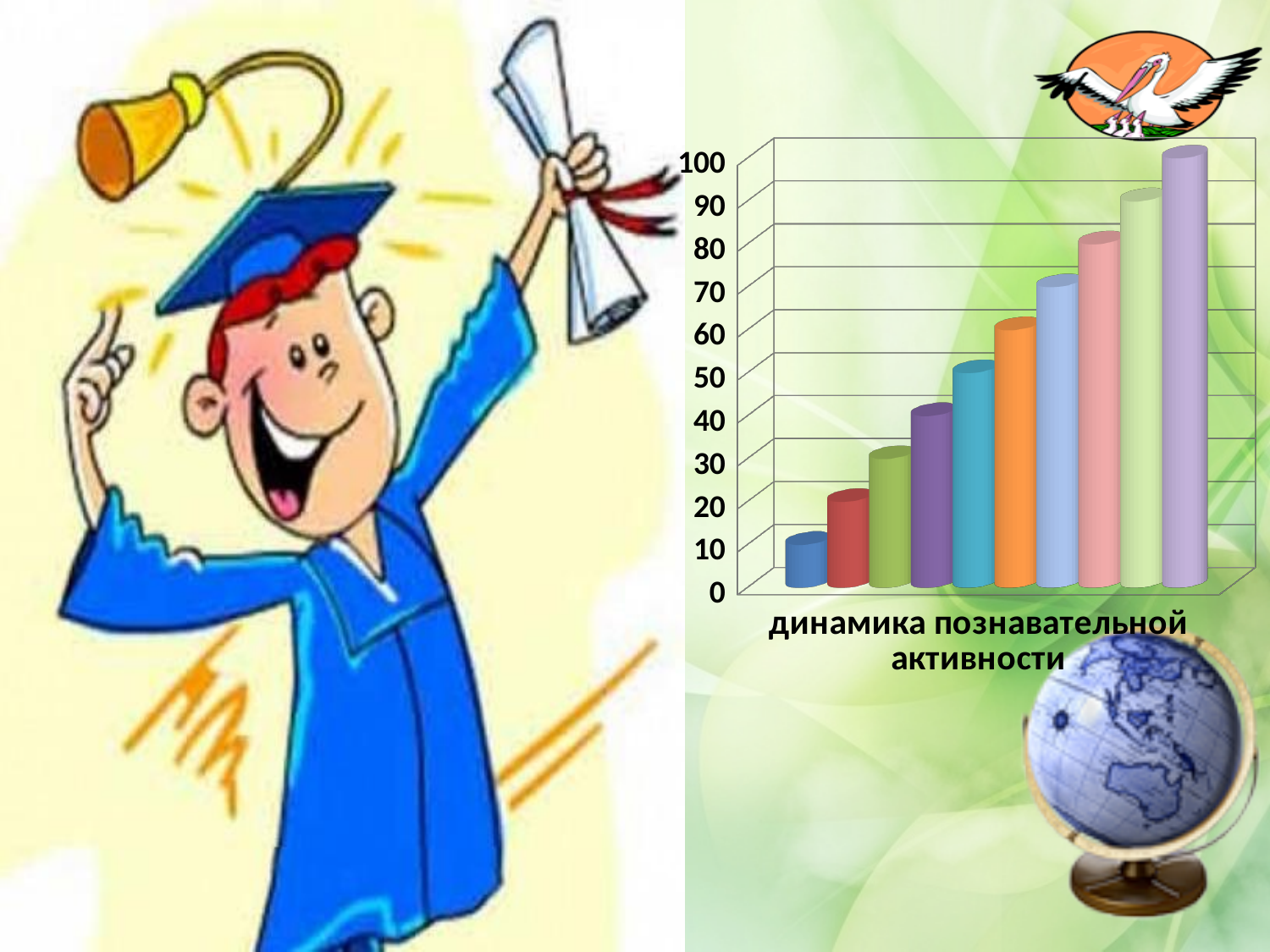
Do the bar values rise or fall from left to right across the chart? rise What is the value of the tallest bar in the chart? 100 What is the highest value shown on the vertical axis? 100 Which is larger, the orange bar or the red bar? the orange bar What kind of chart is shown on the slide? bar chart Which bar is the tallest in the chart? the rightmost (purple) bar What label is printed under the bars on the horizontal axis? динамика познавательной активности How many bars are plotted in the chart? 10 Which bar is the shortest in the chart? the leftmost (blue) bar Is the value of the rightmost bar greater or less than 90? greater Is the value of the fifth bar from the left (teal) greater or less than 40? greater Is the value of the leftmost bar greater or less than 20? less